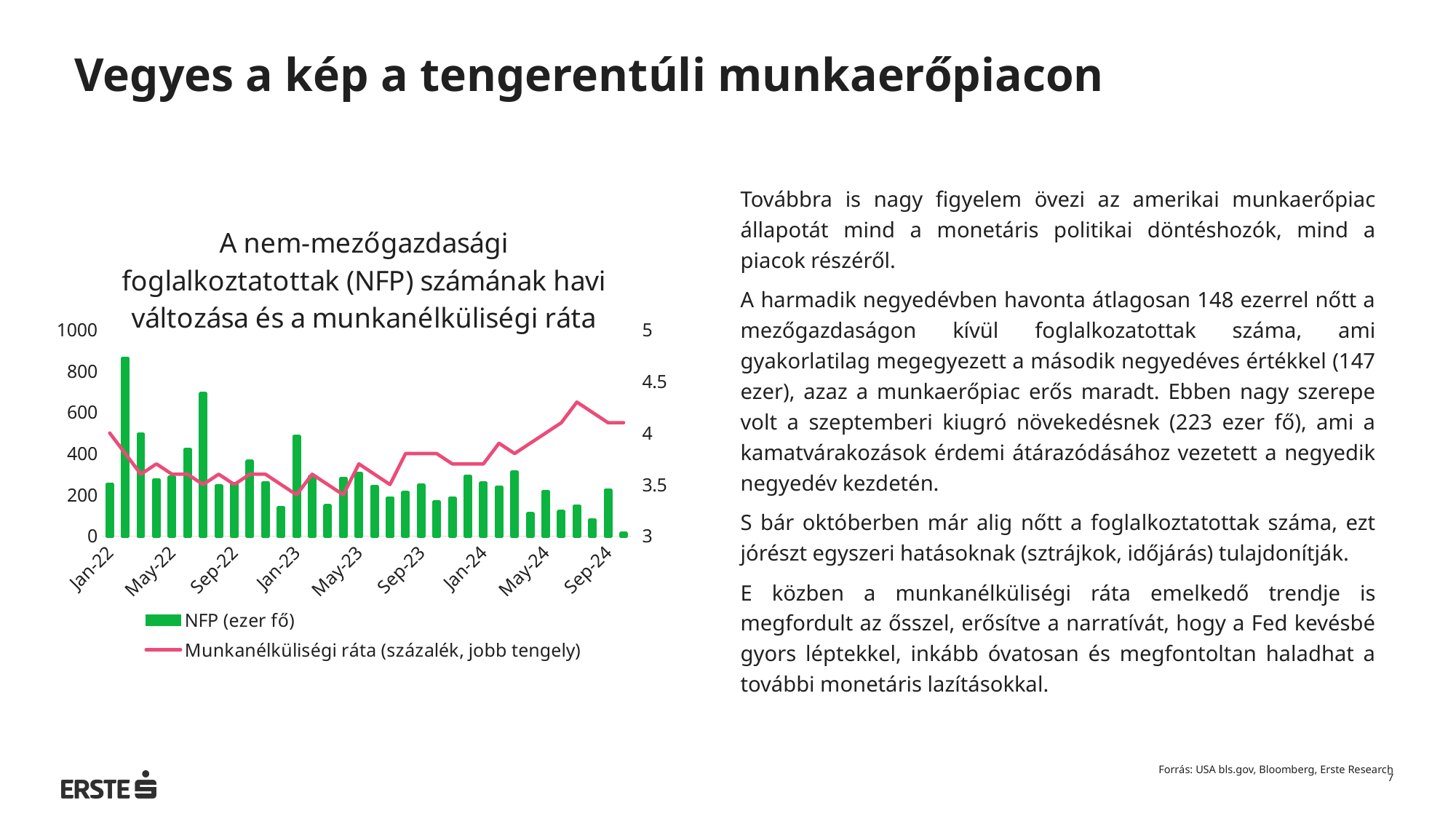
Does the unemployment rate line rise or fall between Jan-24 and Sep-24? rise Is the tallest NFP bar greater or less than 800? greater Is the NFP value for Jan-22 greater or less than 400? less Is the unemployment rate for May-24 greater or less than 3.5? greater Which has the larger NFP value, Jan-23 or Jan-24? Jan-23 How many month labels are shown on the x axis? 9 What kind of chart is shown on the slide? A combined bar and line chart What colour are the NFP bars? Green Which series is plotted on the right axis according to the legend? Munkanélküliségi ráta (százalék, jobb tengely) How many series does the chart legend list? 2